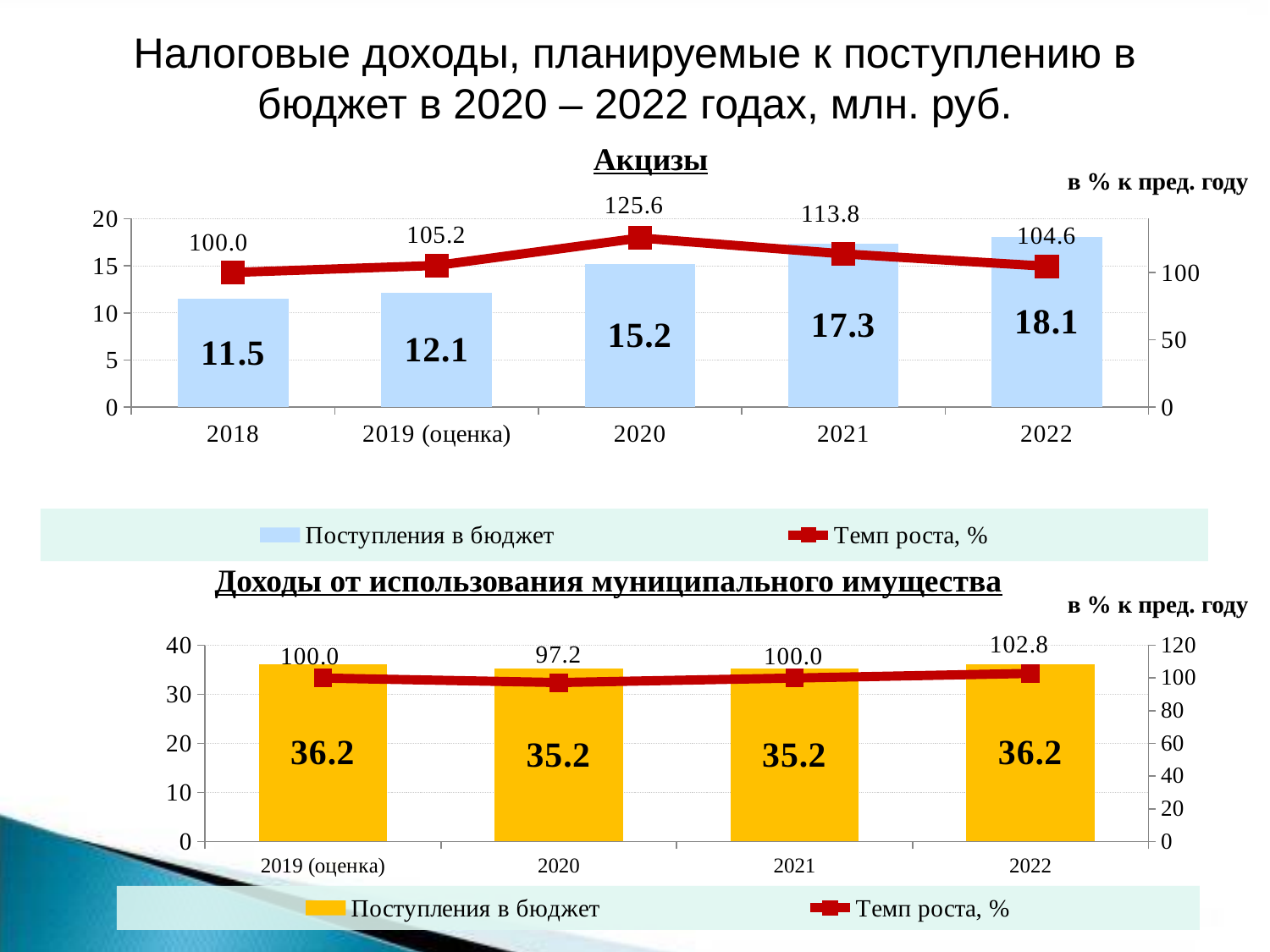
In the 'Доходы от использования муниципального имущества' chart, which year has the highest 'Темп роста, %' value? 2022 What type of chart is the 'Доходы от использования муниципального имущества' chart? Combined bar and line chart In the 'Доходы от использования муниципального имущества' chart, what is the 'Темп роста, %' value for 2020? 97.2 In the 'Акцизы' chart, which year has the lowest 'Поступления в бюджет' value? 2018 In the 'Акцизы' chart, what is the difference between the 'Поступления в бюджет' values for 2022 and 2018? 6.6 In the 'Акцизы' chart, which year has the highest 'Темп роста, %' value? 2020 In the 'Доходы от использования муниципального имущества' chart, what is the 'Поступления в бюджет' value for 2021? 35.2 In the 'Акцизы' chart, how many years are shown on the x axis? 5 In the 'Доходы от использования муниципального имущества' chart, how many series does the legend list? 2 In the 'Акцизы' chart, what is the 'Темп роста, %' value for 2021? 113.8 In the 'Акцизы' chart, do the 'Поступления в бюджет' bars rise or fall from 2018 to 2022? rise In the 'Акцизы' chart, what is the value of 'Поступления в бюджет' for 2020? 15.2